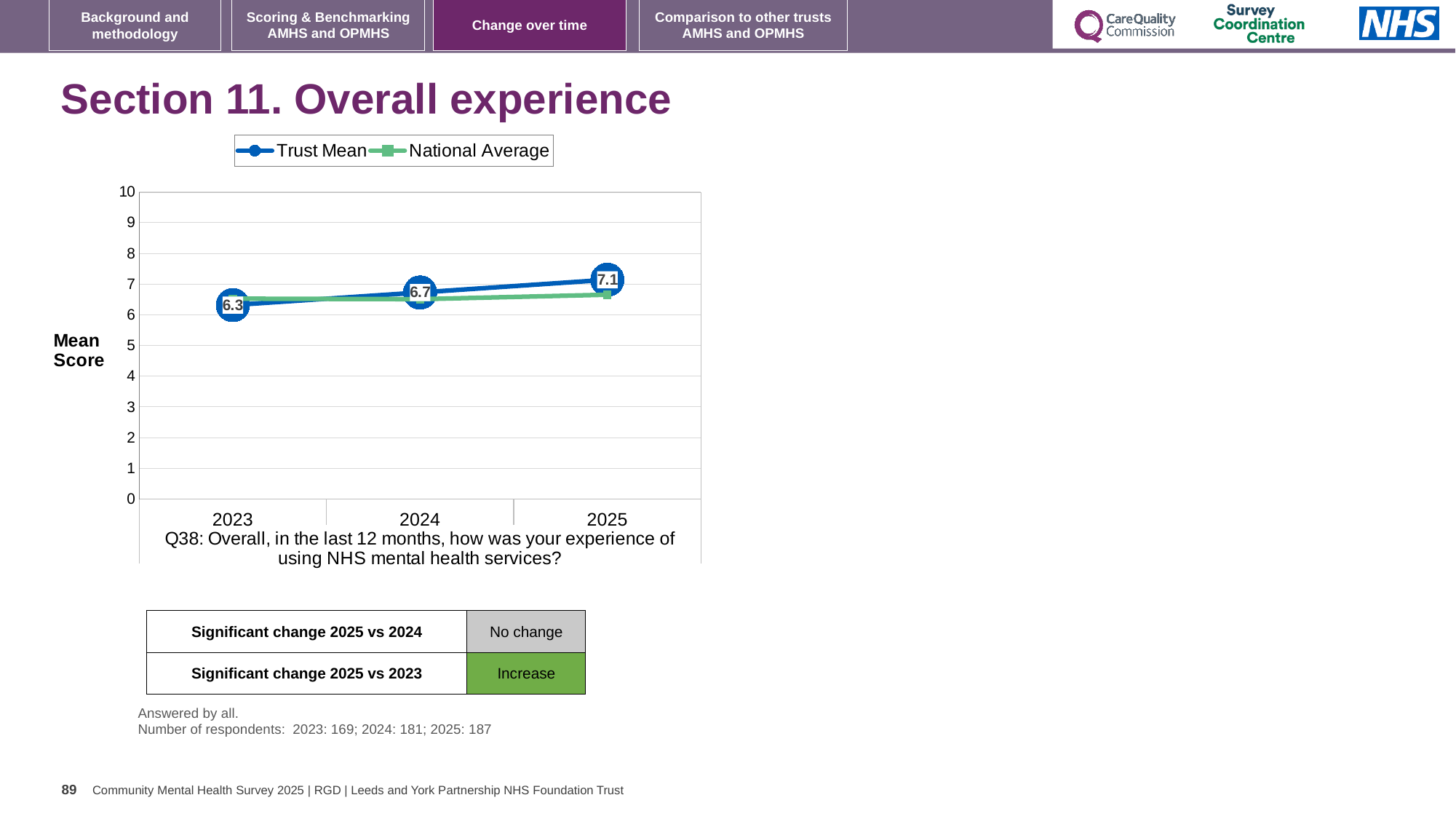
How many years are plotted on the x axis of the chart? 3 How many series does the chart legend list? 2 Does the Trust Mean score rise or fall from 2023 to 2025? rise What is the Trust Mean score for 2025? 7.1 What is the difference between the Trust Mean scores for 2024 and 2023? 0.4 By how much did the Trust Mean score change from 2023 to 2025? 0.8 What is the Trust Mean score for 2024? 6.7 In which year is the Trust Mean score highest? 2025 Is the National Average value for 2025 greater or less than 6? greater What is the Trust Mean score for 2023? 6.3 What kind of chart is shown on the slide? line chart In which year is the Trust Mean score lowest? 2023